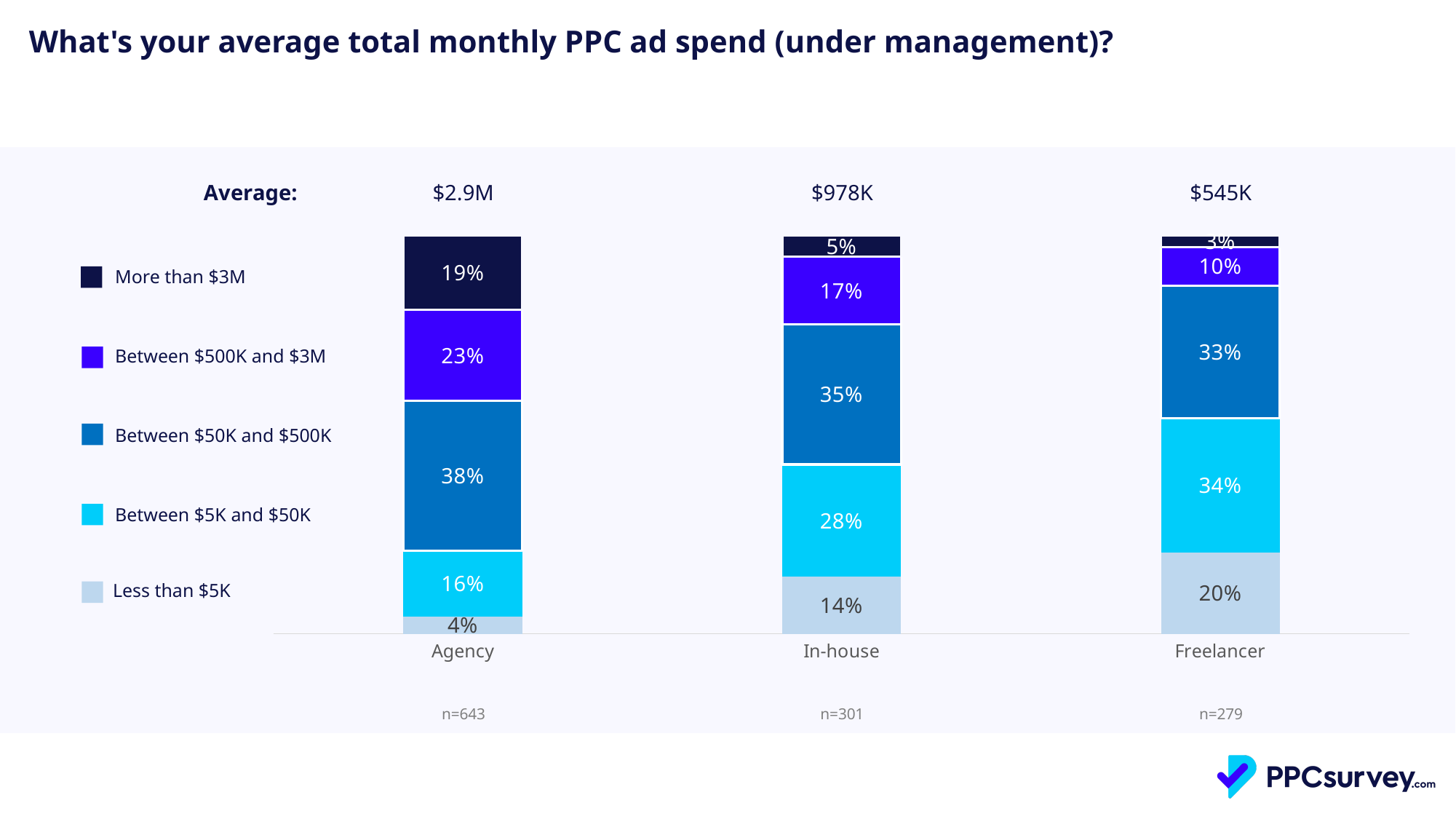
What kind of chart is shown on the slide? Stacked bar chart Which respondent group has the lowest share spending less than $5K per month? Agency What is the average monthly PPC ad spend shown for Agency respondents? $2.9M What is the difference between the Agency and Freelancer shares for the 'Between $500K and $3M' category? 13% How many spend categories does the legend list? 5 What is the sample size (n) for the In-house group? n=301 What percentage of In-house respondents spend between $5K and $50K per month? 28% Which respondent group has the highest share spending more than $3M per month? Agency How many respondent groups are shown on the x axis? 3 What percentage of Agency respondents have a monthly PPC ad spend between $50K and $500K? 38% What percentage of Freelancer respondents spend less than $5K per month? 20% Which is larger: the In-house share spending between $50K and $500K, or the Freelancer share in the same category? In-house